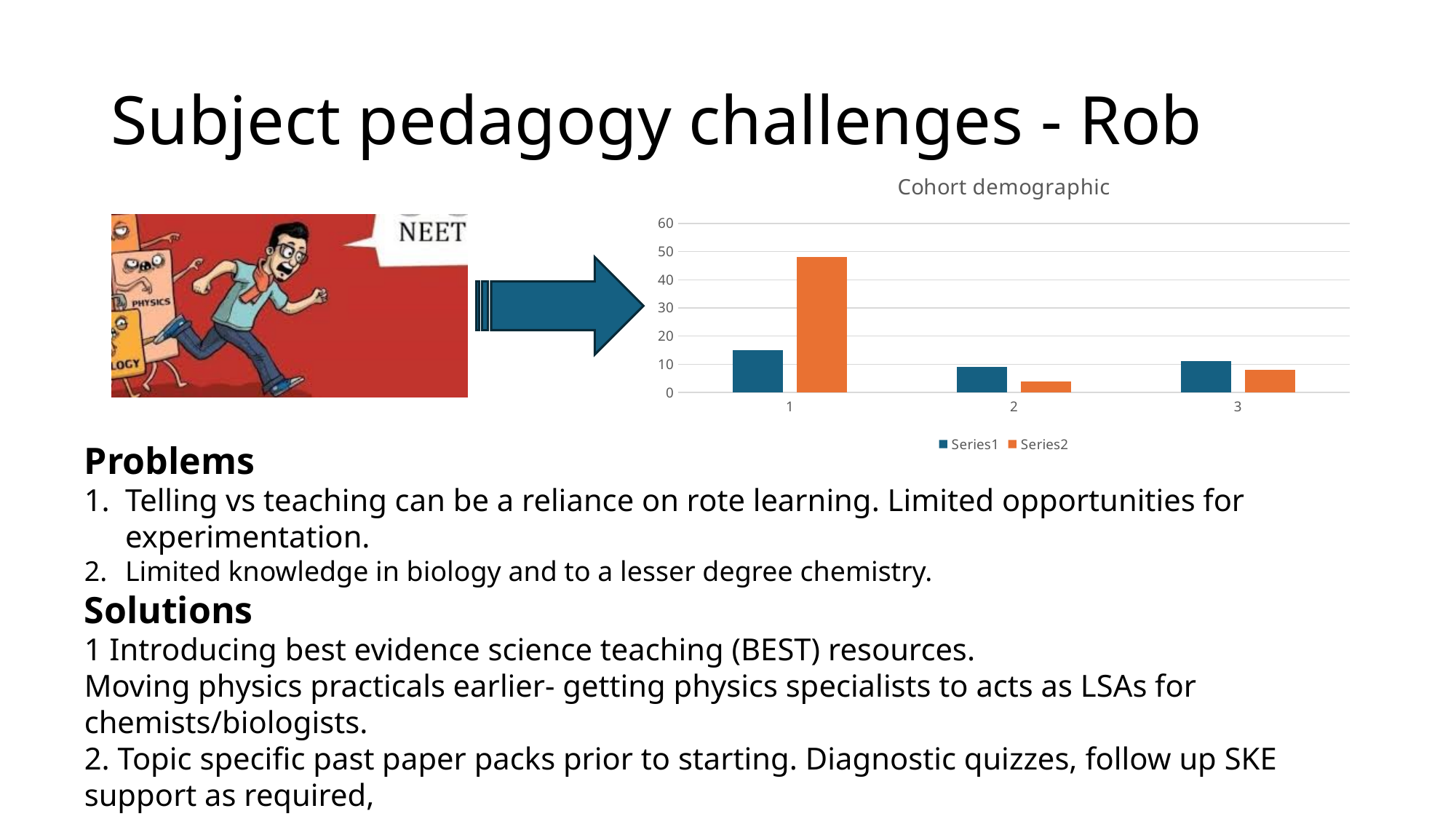
In the Cohort demographic chart, is the Series1 value for category 1 greater or less than 10? greater What is the title of the chart on the slide? Cohort demographic In the Cohort demographic chart, which category has the highest Series2 value? 1 What kind of chart is the Cohort demographic chart? bar chart How many categories are shown on the x axis of the Cohort demographic chart? 3 In the Cohort demographic chart, for category 2, which series has the larger value, Series1 or Series2? Series1 In the Cohort demographic chart, is the Series2 value for category 1 greater or less than 40? greater In the Cohort demographic chart, which category has the highest Series1 value? 1 In the Cohort demographic chart, for category 1, which series has the larger value, Series1 or Series2? Series2 How many series does the legend of the Cohort demographic chart list? 2 In the Cohort demographic chart, which category has the lowest Series2 value? 2 In the Cohort demographic chart, is the Series2 value for category 2 greater or less than 10? less